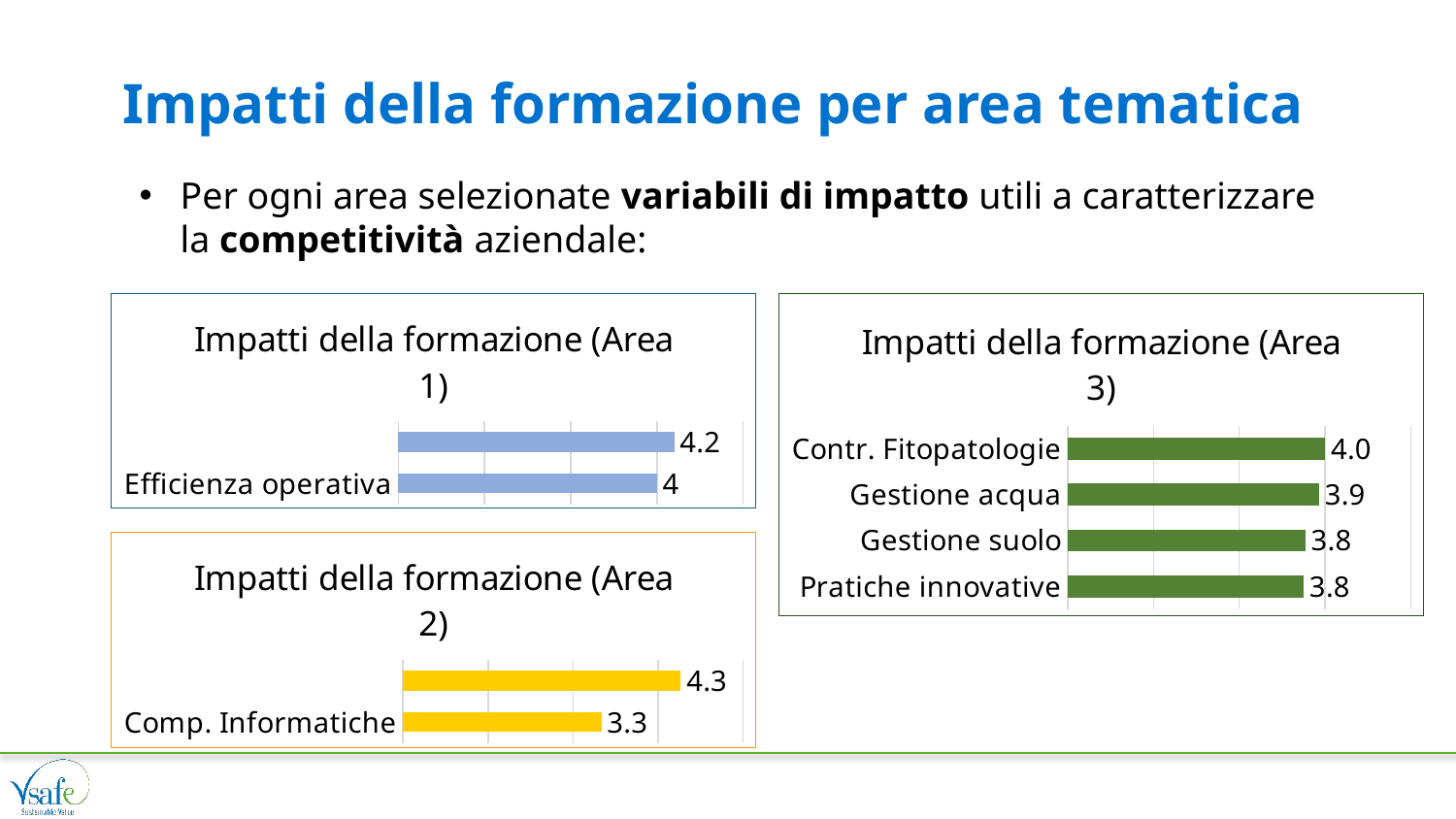
In the chart 'Impatti della formazione (Area 1)', what is the value for Efficienza operativa? 4 How many bars are shown in the chart 'Impatti della formazione (Area 3)'? 4 In the chart 'Impatti della formazione (Area 3)', which category has the highest value? Contr. Fitopatologie In the chart 'Impatti della formazione (Area 3)', what is the difference between Contr. Fitopatologie and Gestione suolo? 0.2 How many bars are shown in the chart 'Impatti della formazione (Area 2)'? 2 In the chart 'Impatti della formazione (Area 3)', what is the value for Gestione acqua? 3.9 What type of chart is 'Impatti della formazione (Area 3)'? Bar chart In the chart 'Impatti della formazione (Area 3)', which is larger: Gestione acqua or Pratiche innovative? Gestione acqua What colour are the bars in the chart 'Impatti della formazione (Area 2)'? Yellow How many charts are shown on the slide? 3 In the chart 'Impatti della formazione (Area 3)', what is the value for Contr. Fitopatologie? 4.0 In the chart 'Impatti della formazione (Area 2)', what is the value for Comp. Informatiche? 3.3